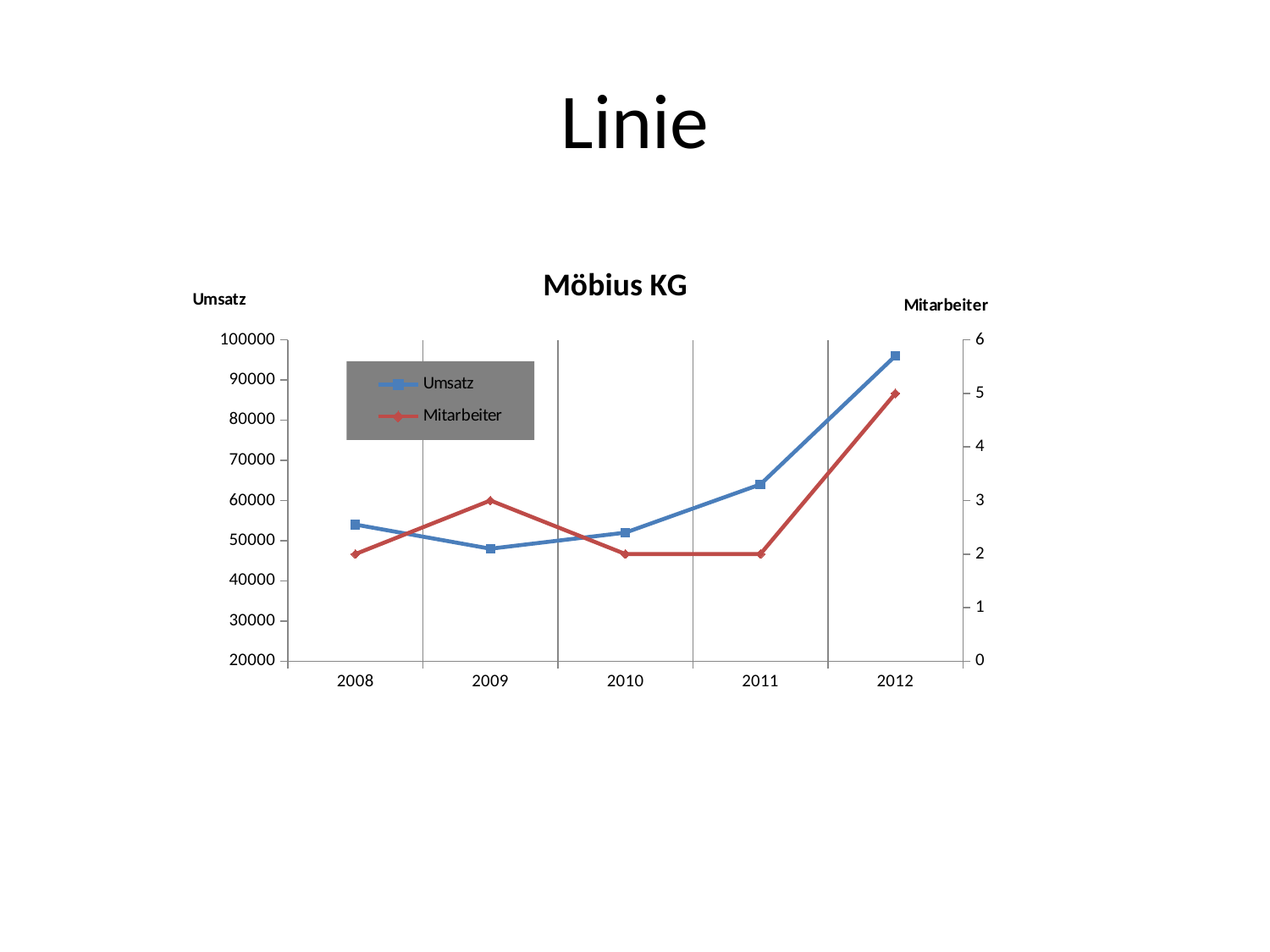
What is the difference between the Mitarbeiter value in 2012 and in 2008? 3 What kind of chart is shown on the slide? line chart Is the Umsatz value for 2009 greater or less than 50000? less What is the Mitarbeiter value for 2009? 3 What is the title of the chart? Möbius KG In which year is Umsatz lowest? 2009 What is the Mitarbeiter value for 2008? 2 How many years are plotted along the x axis? 5 Is the Umsatz value for 2012 greater or less than 90000? greater How many series does the legend list? 2 What is the Mitarbeiter value for 2012? 5 In which year is Umsatz highest? 2012